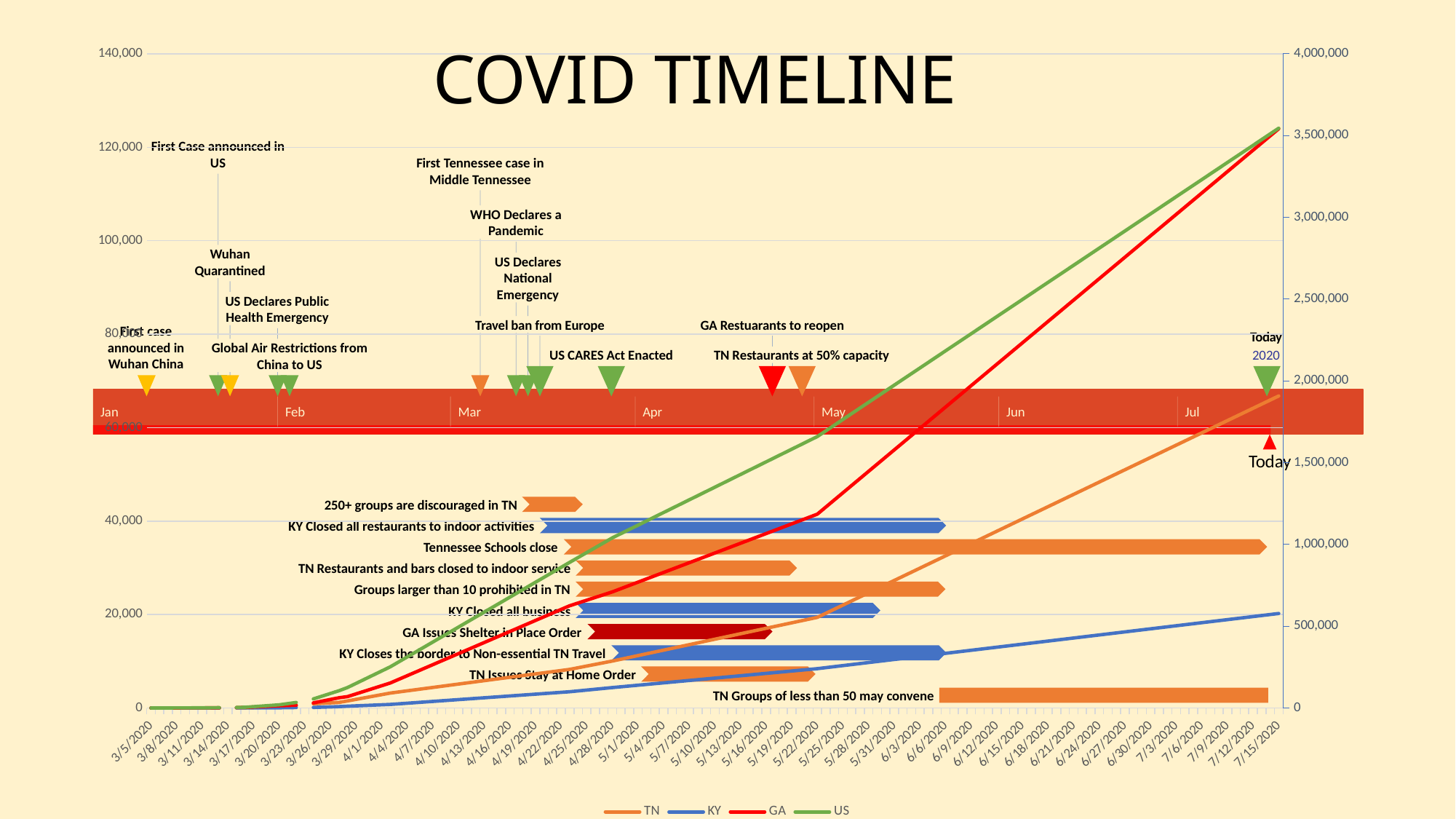
At 7/15/2020, which series is higher in the COVID TIMELINE chart, TN or KY? TN What is the maximum value shown on the left vertical axis of the COVID TIMELINE chart? 140,000 What colour is the GA line in the COVID TIMELINE chart? red Which series is the lowest at 7/15/2020 in the COVID TIMELINE chart? KY On the left axis, is the KY value at 7/15/2020 greater or less than 40,000? less What is the maximum value shown on the right vertical axis of the COVID TIMELINE chart? 4,000,000 Do the case-count lines in the COVID TIMELINE chart rise or fall from 3/5/2020 to 7/15/2020? rise What are the series names listed in the legend of the COVID TIMELINE chart? TN, KY, GA, US On the left axis, is the TN value at 7/15/2020 greater or less than 40,000? greater What kind of chart is shown on the COVID TIMELINE slide? line chart How many series does the legend of the COVID TIMELINE chart list? 4 On the left axis, is the KY value at 7/15/2020 greater or less than 10,000? greater